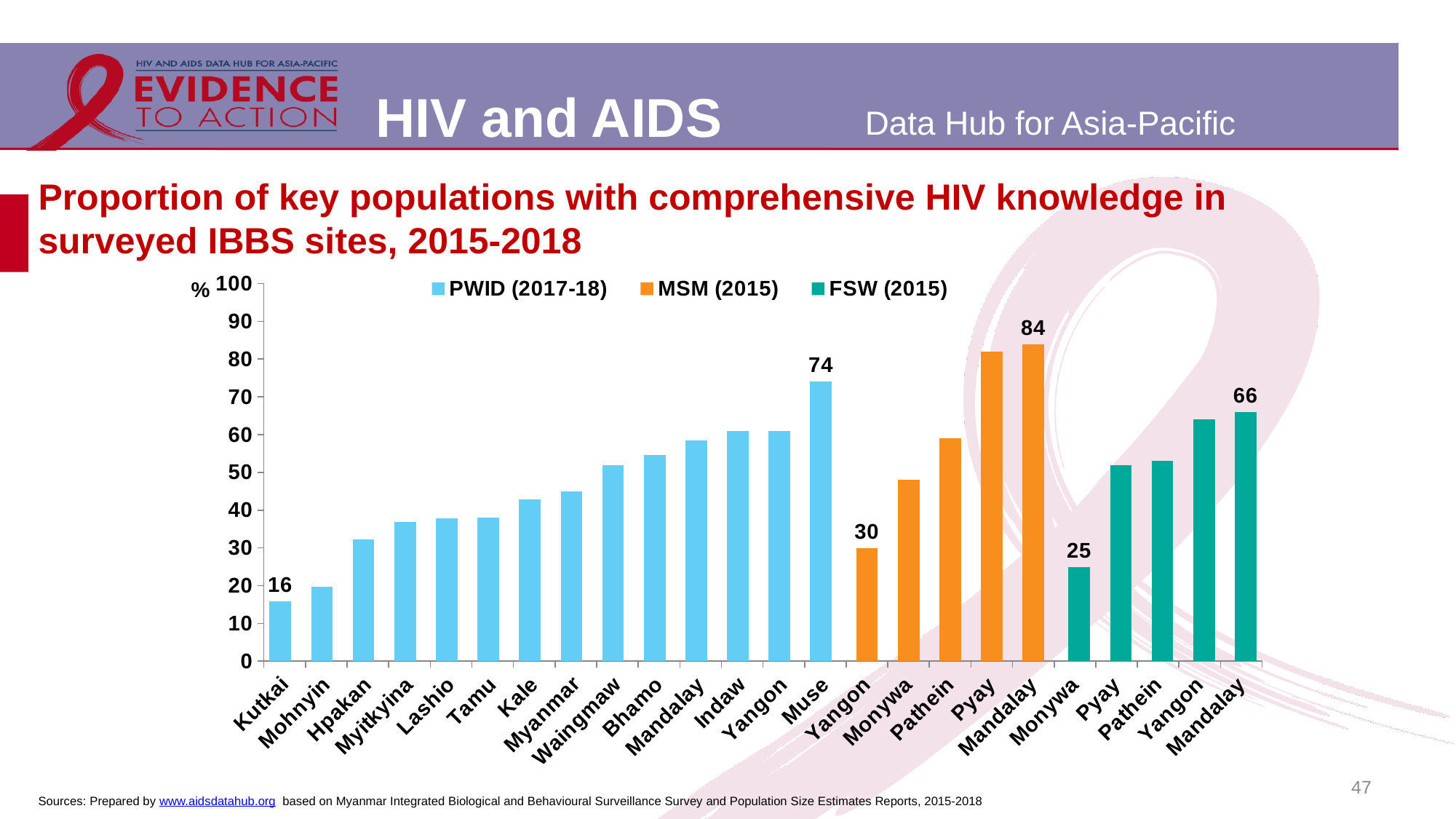
Do the PWID (2017-18) values rise or fall from Kutkai to Muse along the x axis? rise How many series does the legend list? 3 What is the value for Mandalay in the MSM (2015) series? 84 Which is larger: the value for Muse in the PWID series or the value for Mandalay in the FSW series? Muse (PWID) What is the value for Kutkai in the PWID (2017-18) series? 16 Which site and series has the highest value on the chart? Mandalay, MSM (2015) Which site has the lowest value on the chart? Kutkai What is the difference between the values for Muse and Kutkai in the PWID (2017-18) series? 58 What is the difference between the values for Mandalay and Yangon in the MSM (2015) series? 54 Is the value for Pathein in the MSM (2015) series greater or less than 50? greater What is the value for Muse in the PWID (2017-18) series? 74 What is the value for Monywa in the FSW (2015) series? 25